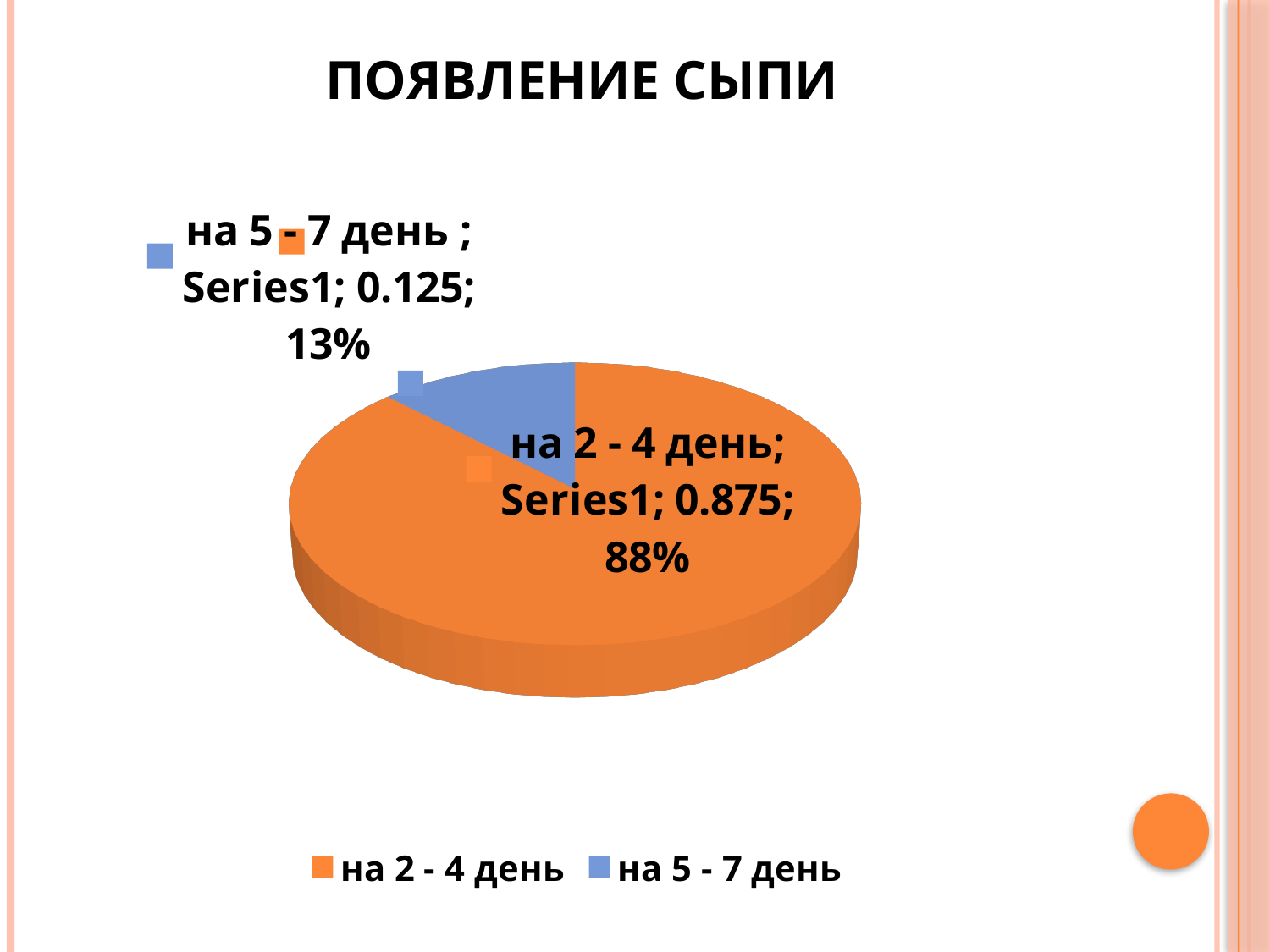
What percentage share does the slice "на 2 - 4 день" have? 88% What is the difference between the values for "на 2 - 4 день" and "на 5 - 7 день"? 0.75 What colour is the slice for "на 5 - 7 день"? blue Which slice is the smallest? на 5 - 7 день What value is printed for "на 2 - 4 день"? 0.875 Which is larger, the value for "на 2 - 4 день" or for "на 5 - 7 день"? на 2 - 4 день Which slice is the largest? на 2 - 4 день What percentage share does the slice "на 5 - 7 день" have? 13% How many slices does the pie chart have? 2 What value is printed for "на 5 - 7 день"? 0.125 What kind of chart is shown on the slide? pie chart What is the title of the chart? ПОЯВЛЕНИЕ СЫПИ